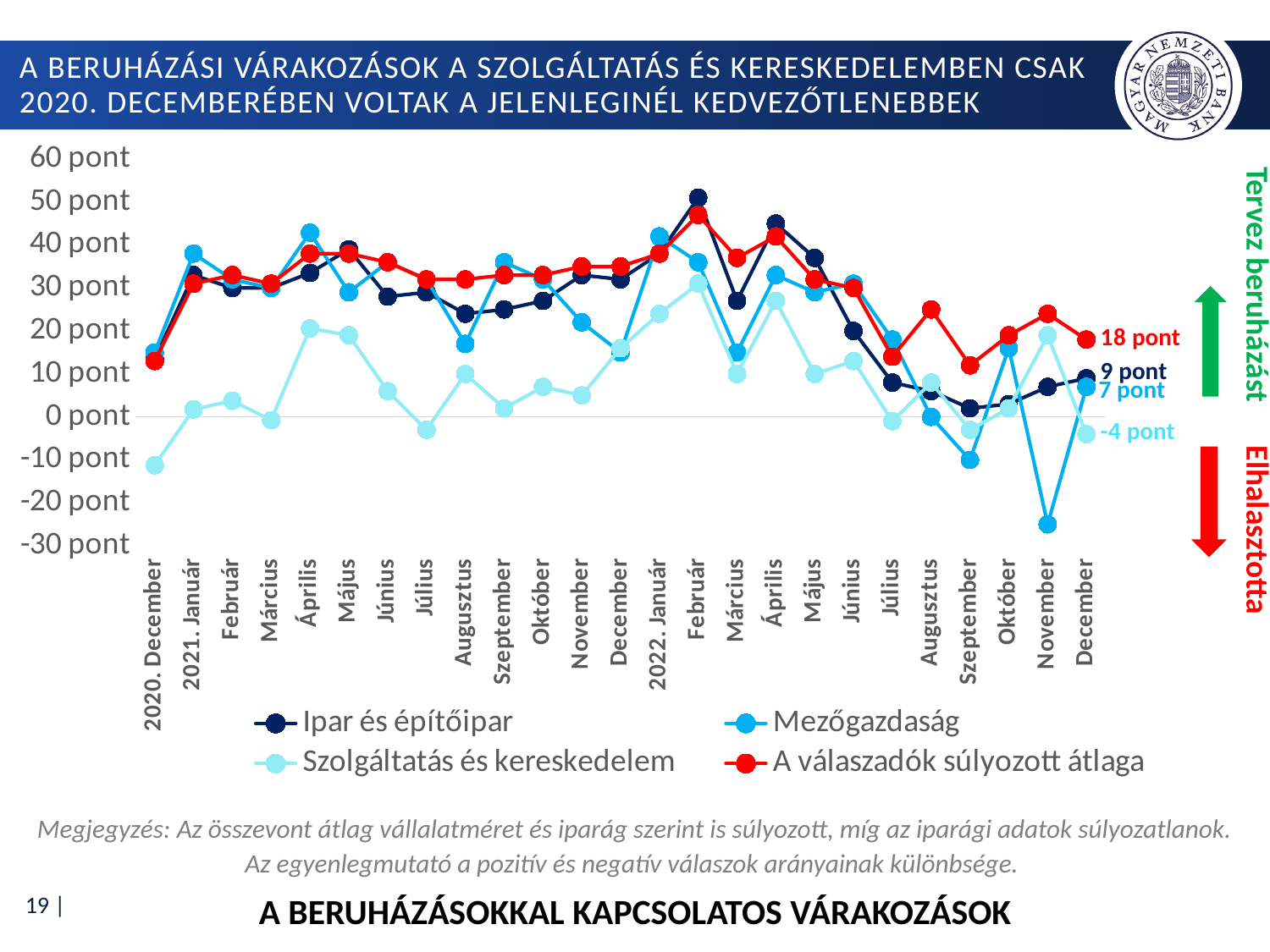
How many months are shown along the x axis? 25 Which series has the highest value in December 2022? A válaszadók súlyozott átlaga What kind of chart is shown on the slide? line chart Is the value for 'Mezőgazdaság' in November 2022 greater or less than -20 pont? less What is the difference between 'A válaszadók súlyozott átlaga' and 'Ipar és építőipar' in December 2022? 9 pont How many series does the legend list? 4 What is the value of 'A válaszadók súlyozott átlaga' in December 2022? 18 pont What is the value of 'Mezőgazdaság' in December 2022? 7 pont Which series has the lowest value in December 2022? Szolgáltatás és kereskedelem What is the value of 'Ipar és építőipar' in December 2022? 9 pont What colour is the line for 'A válaszadók súlyozott átlaga'? red What is the value of 'Szolgáltatás és kereskedelem' in December 2022? -4 pont